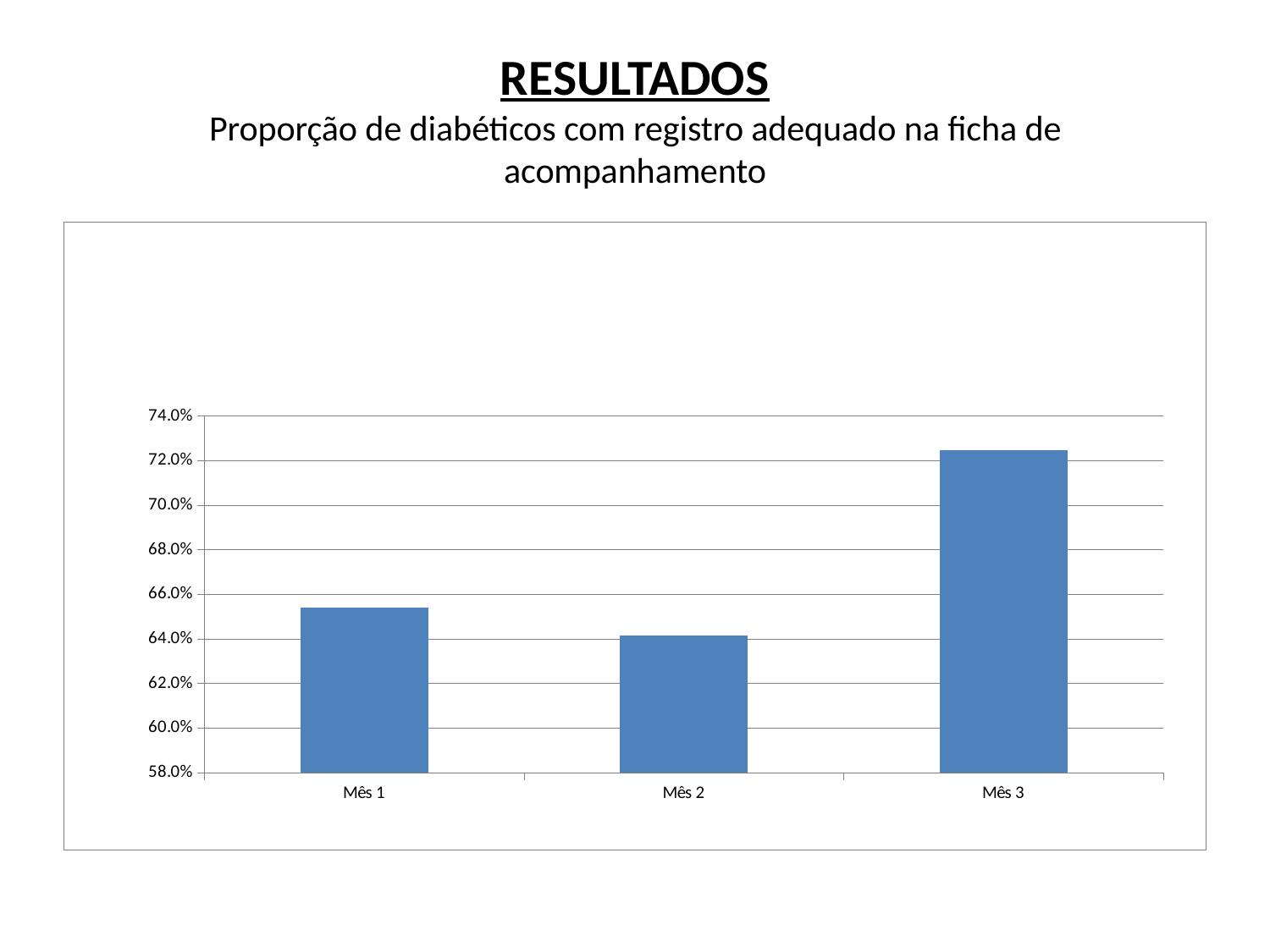
Is the value for Mês 1 greater or less than 64.0%? greater Is the value for Mês 2 greater or less than 66.0%? less Does the value fall or rise from Mês 2 to Mês 3? rise How many categories (months) are plotted on the chart? 3 What is the lowest value shown on the vertical axis of the chart? 58.0% Which is larger, the value for Mês 3 or the value for Mês 1? Mês 3 Is the value for Mês 3 greater or less than 70.0%? greater Which is larger, the value for Mês 1 or the value for Mês 2? Mês 1 Which month has the highest proportion? Mês 3 Which month has the lowest proportion? Mês 2 What kind of chart is shown on the slide? bar chart